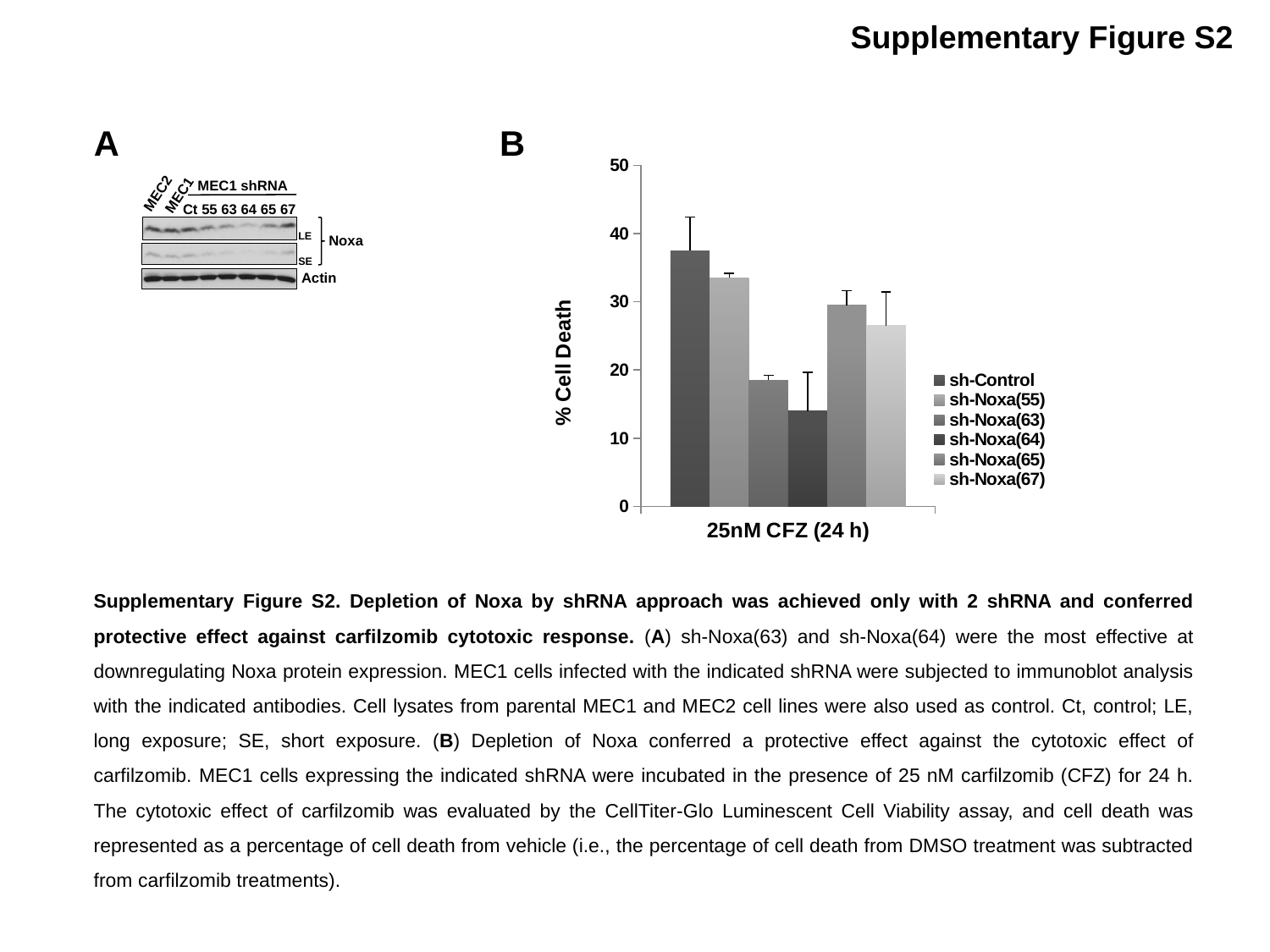
In the chart in panel B, which series has the highest % Cell Death? sh-Control In the chart in panel B, is the value for sh-Noxa(55) greater or less than 40? less What is the y-axis title of the chart in panel B? % Cell Death In the chart in panel B, is the value for sh-Noxa(64) greater or less than 10? greater What is the x-axis category label of the chart in panel B? 25nM CFZ (24 h) In the chart in panel B, is the value for sh-Control greater or less than 30? greater In the chart in panel B, which is larger, the value for sh-Noxa(65) or the value for sh-Noxa(64)? sh-Noxa(65) How many series does the legend of the chart in panel B list? 6 What kind of chart is shown in panel B? bar chart In the chart in panel B, which is larger, the value for sh-Noxa(55) or the value for sh-Noxa(63)? sh-Noxa(55) In the chart in panel B, which series has the lowest % Cell Death? sh-Noxa(64)